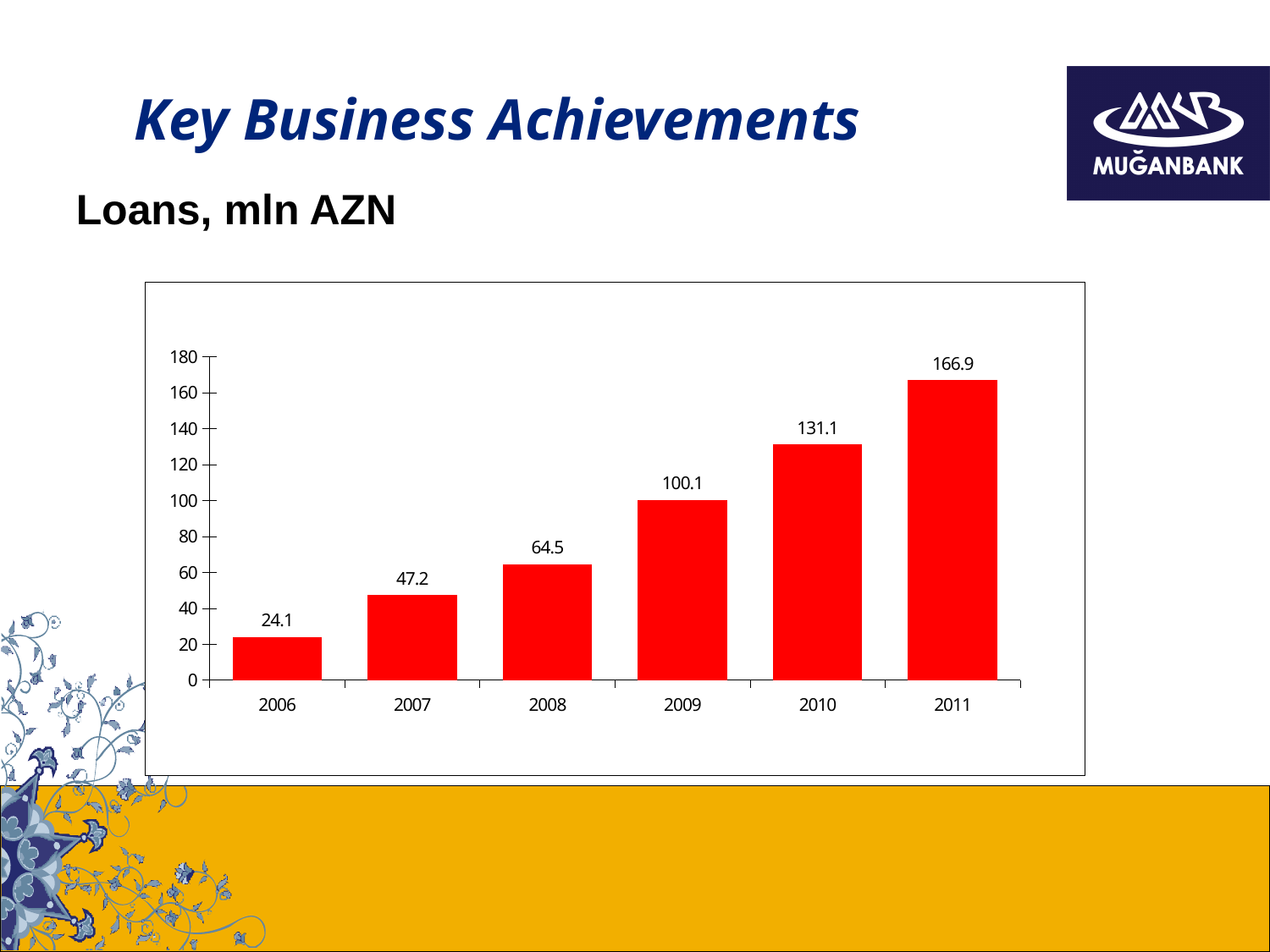
What is the difference between the loan values for 2011 and 2010? 35.8 What is the value of loans for 2006? 24.1 Which year has a larger loan value, 2008 or 2010? 2010 Which year has the highest loan value? 2011 Is the value for 2010 greater or less than 120? greater What is the difference between the loan values for 2008 and 2007? 17.3 What is the value of loans for 2011? 166.9 Which year has the lowest loan value? 2006 How many years are shown on the chart? 6 What kind of chart is shown on the slide? bar chart What is the value of loans for 2009? 100.1 Do the loan values rise or fall from 2006 to 2011? rise